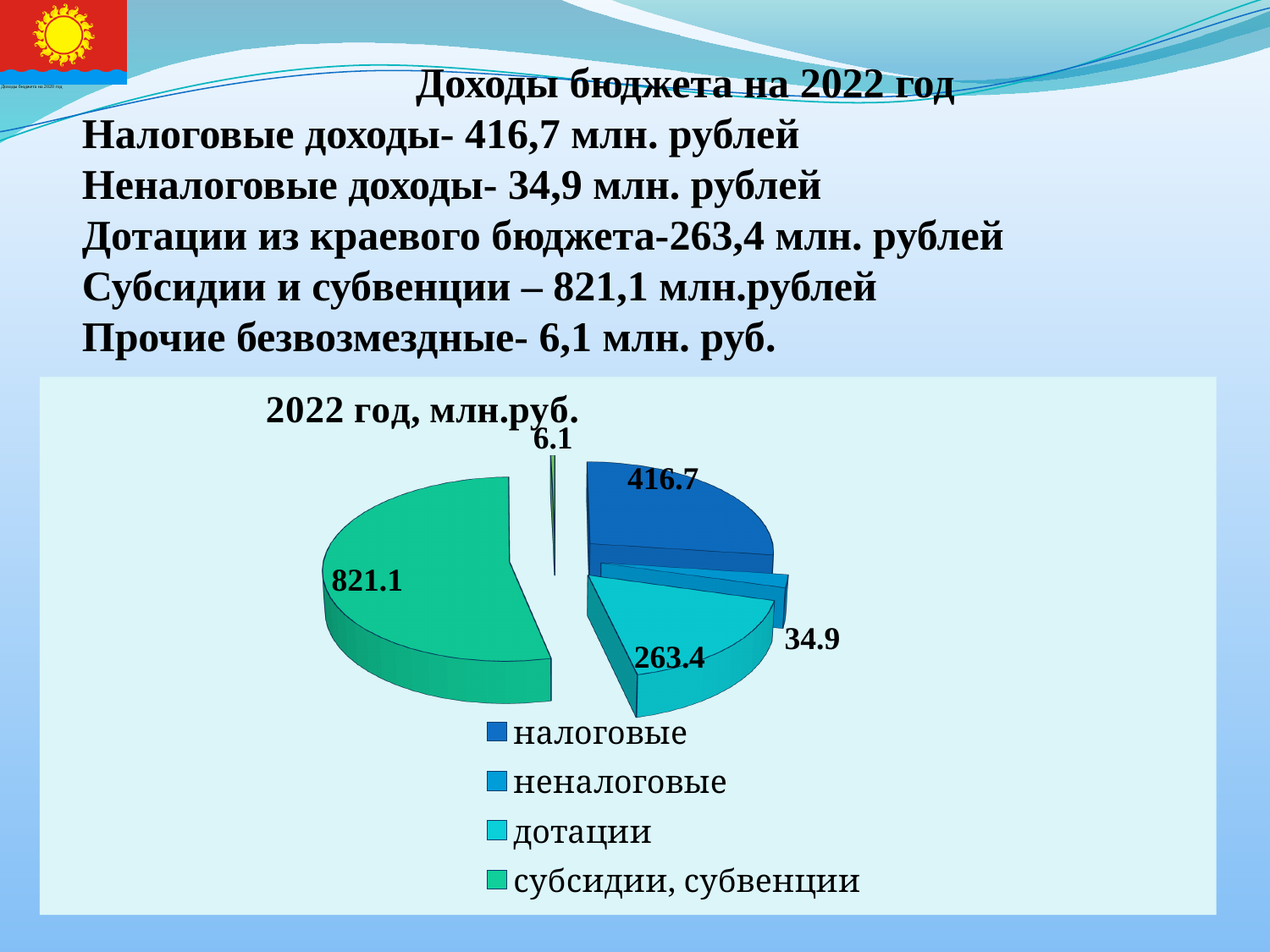
How many entries does the chart legend list? 4 What is the value of the неналоговые slice in the pie chart? 34.9 What is the value of the налоговые slice in the pie chart? 416.7 What is the value of the дотации slice in the pie chart? 263.4 What is the smallest value labelled on the pie chart? 6.1 What is the difference between the субсидии, субвенции slice and the налоговые slice? 404.4 What type of chart is shown on the slide? pie chart What is the value of the субсидии, субвенции slice in the pie chart? 821.1 Which is larger, the налоговые slice or the дотации slice? налоговые Which category has the largest slice in the pie chart? субсидии, субвенции What is the title of the chart? 2022 год, млн.руб. How many slices does the pie chart have? 5